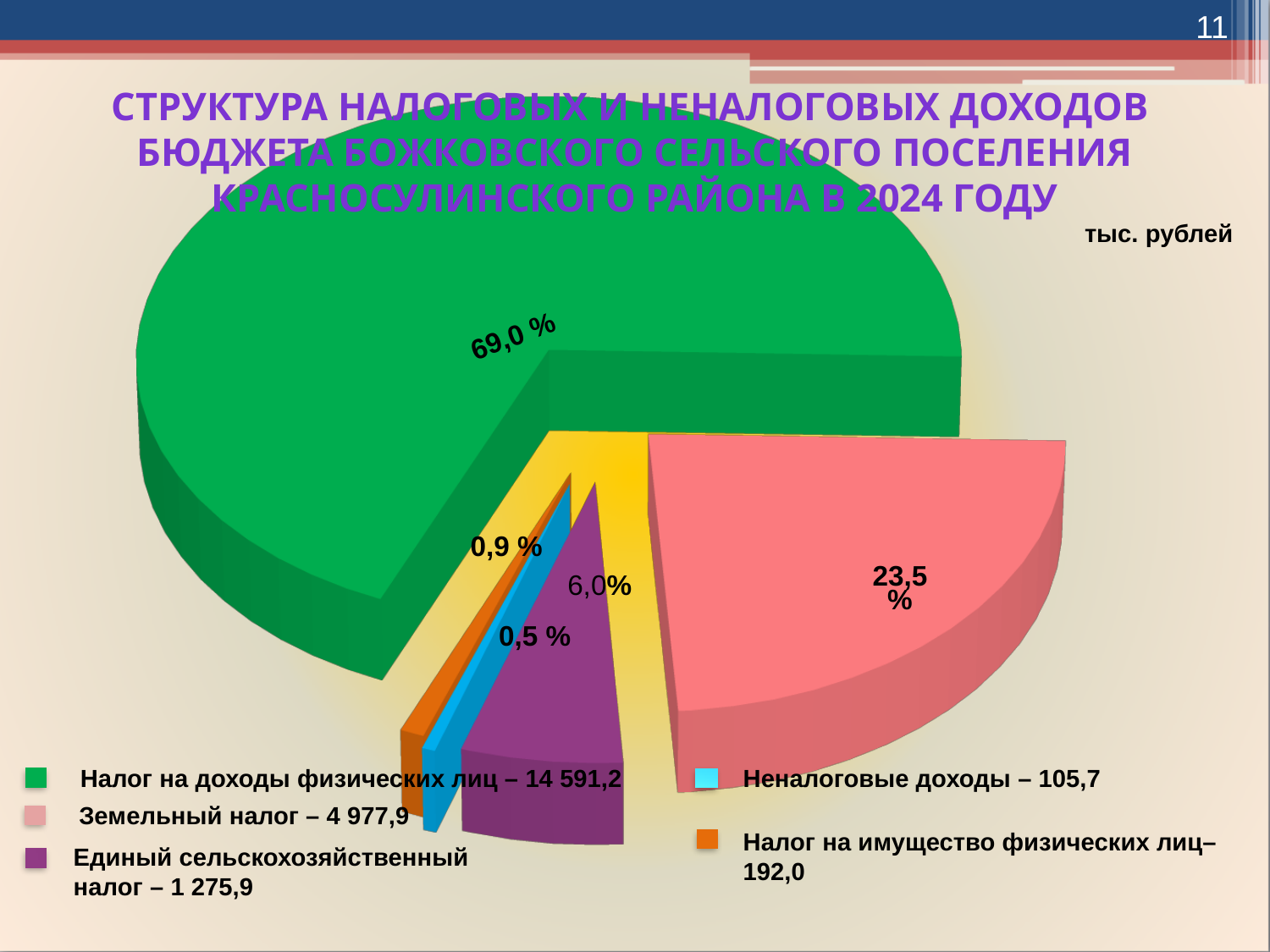
What is the value for Налог на имущество физических лиц shown in the legend? 192,0 What is the value for Налог на доходы физических лиц shown in the legend? 14 591,2 What share of the pie does Единый сельскохозяйственный налог have? 6,0% How many slices does the pie chart have? 5 Which category has the smallest slice of the pie? Неналоговые доходы What is the value for Земельный налог shown in the legend? 4 977,9 What is the value for Неналоговые доходы shown in the legend? 105,7 What share of the pie does Налог на доходы физических лиц have? 69,0 % Which is larger, Земельный налог or Единый сельскохозяйственный налог? Земельный налог What kind of chart is shown on the slide? pie chart Which category has the largest slice of the pie? Налог на доходы физических лиц What share of the pie does Земельный налог have? 23,5 %